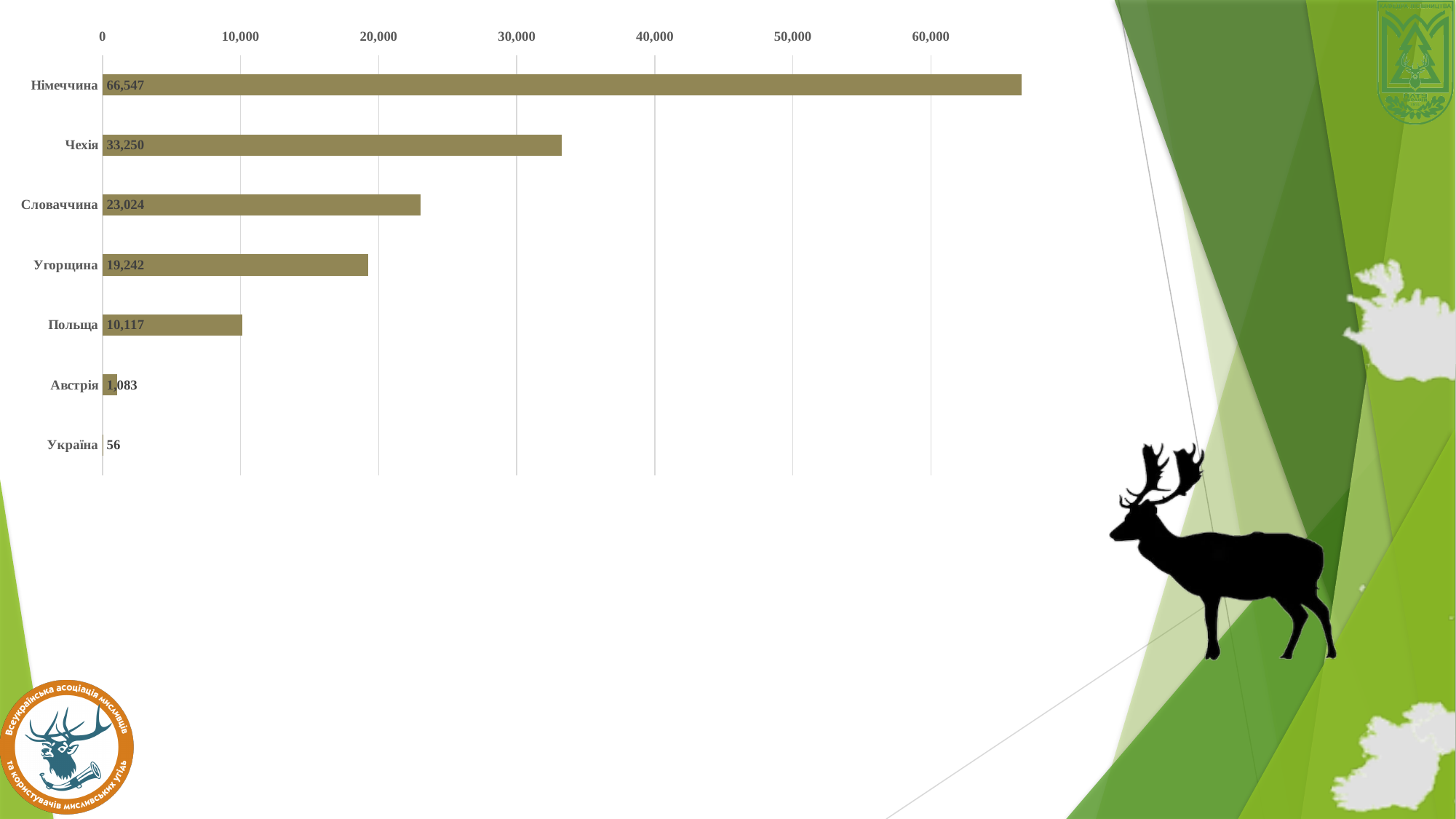
Which category has the highest value? Німеччина Which category has the lowest value? Україна What is the difference between the values for Угорщина and Польща? 9,125 What is the value for Німеччина? 66,547 What is the value for Словаччина? 23,024 What is the difference between the values for Німеччина and Чехія? 33,297 How many categories are shown in the chart? 7 What is the value for Україна? 56 Which is larger, the value for Чехія or the value for Словаччина? Чехія What kind of chart is shown on the slide? bar chart Is the value for Польща greater or less than 20,000? less What is the value for Австрія? 1,083